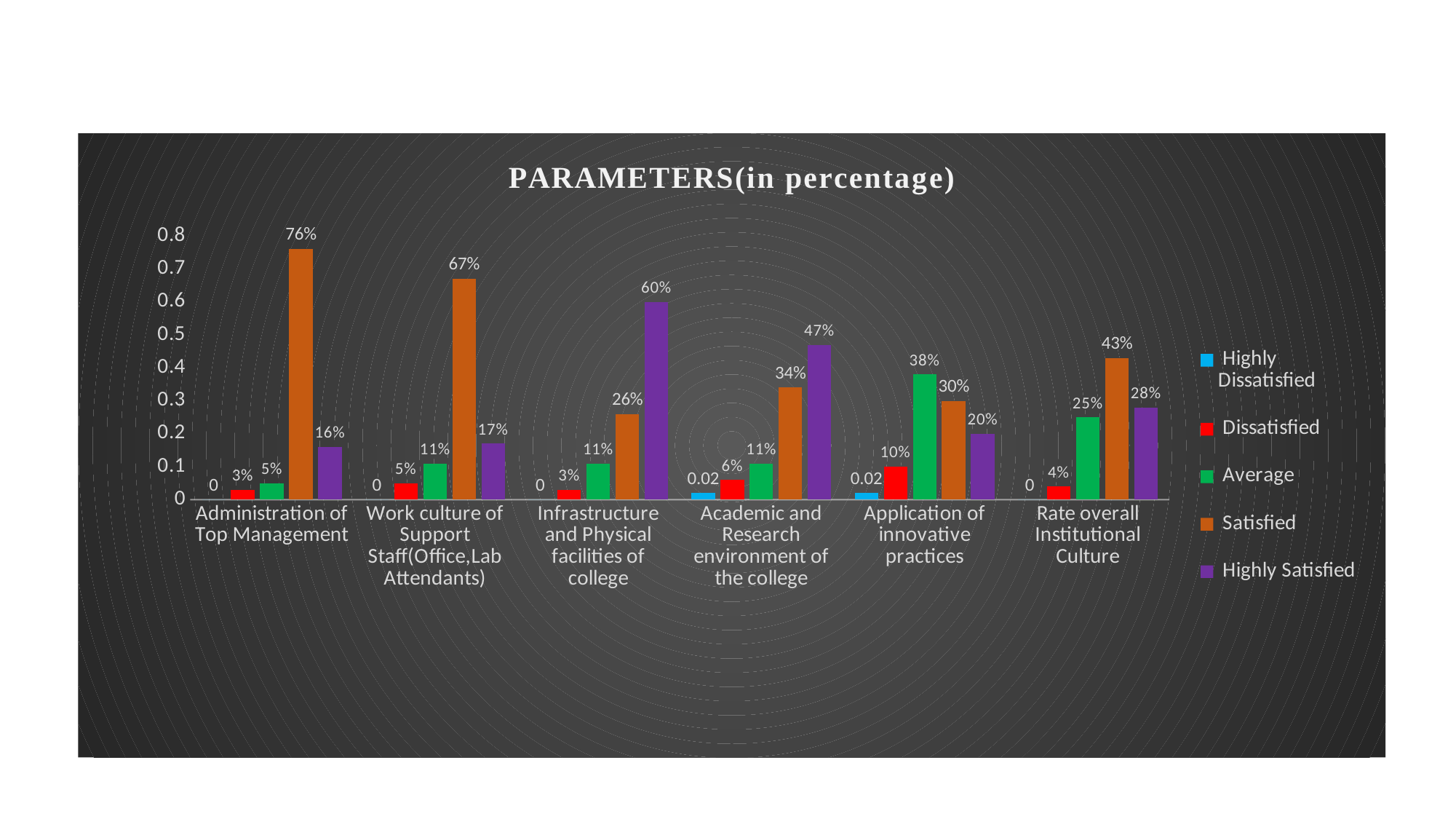
Which category has the highest Satisfied value? Administration of Top Management What kind of chart is shown on the slide? Bar chart What is the title of the chart? PARAMETERS(in percentage) How many categories are shown on the x axis? 6 What is the Satisfied value for Administration of Top Management? 76% Which category has the lowest Highly Satisfied value? Administration of Top Management What is the Highly Satisfied value for Infrastructure and Physical facilities of college? 60% What is the difference between the Satisfied values for Administration of Top Management and Work culture of Support Staff(Office,Lab Attendants)? 9% Which is larger for Rate overall Institutional Culture: the Satisfied value or the Highly Satisfied value? Satisfied What is the Highly Dissatisfied value for Academic and Research environment of the college? 0.02 What is the Average value for Application of innovative practices? 38% How many series does the legend list? 5